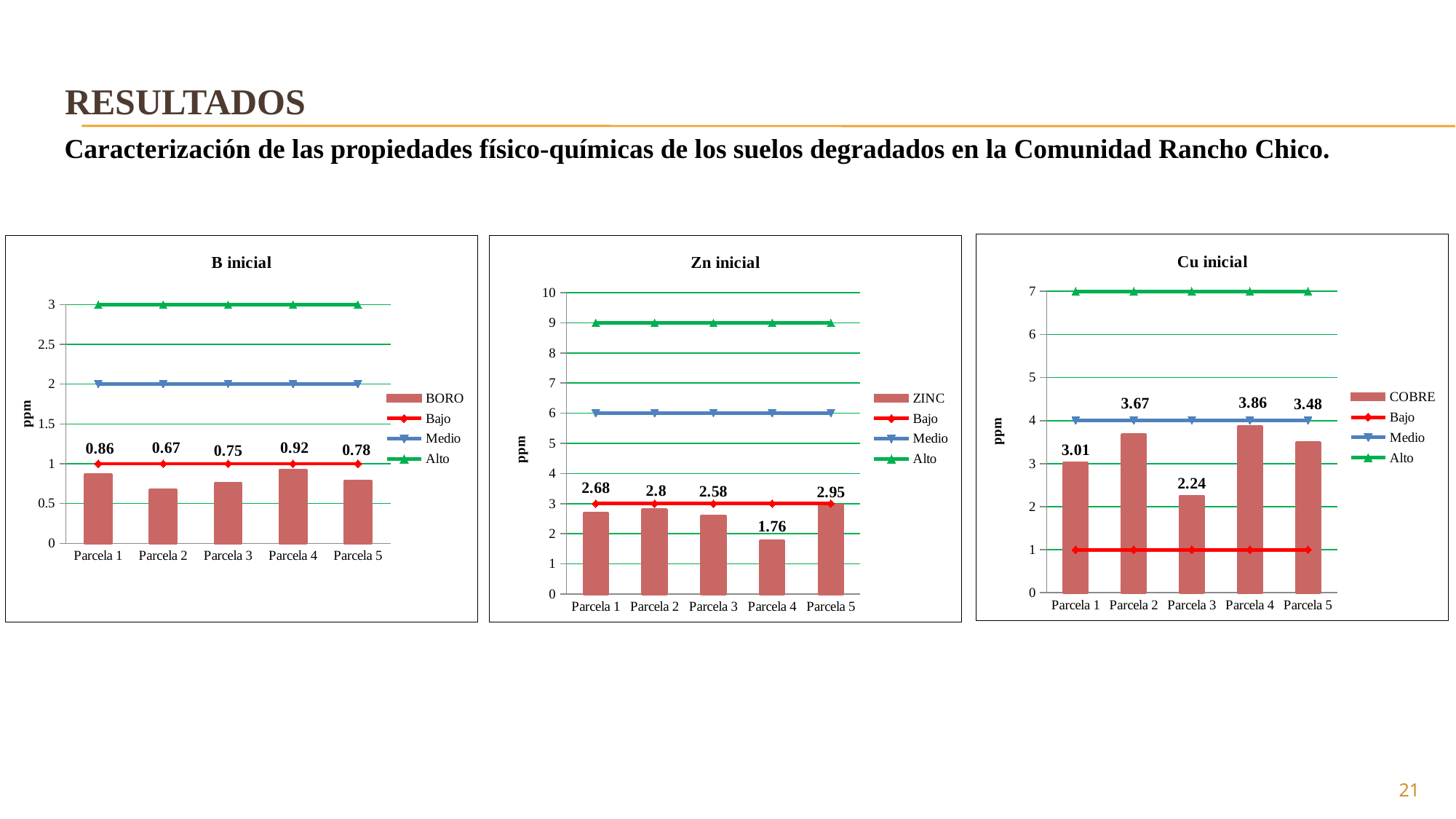
In the 'Cu inicial' chart, what is the COBRE value for Parcela 3? 2.24 What is the y-axis label of the 'B inicial' chart? ppm In the 'B inicial' chart, which parcela has the lowest BORO value? Parcela 2 In the 'Zn inicial' chart, which parcela has the highest ZINC value? Parcela 5 In the 'Cu inicial' chart, which parcela has the highest COBRE value? Parcela 4 How many parcelas are shown on the x axis of the 'Zn inicial' chart? 5 In the 'B inicial' chart, what is the difference between the BORO values for Parcela 4 and Parcela 2? 0.25 In the 'Cu inicial' chart, what is the difference between the COBRE values for Parcela 2 and Parcela 5? 0.19 In the 'B inicial' chart, what is the BORO value for Parcela 4? 0.92 How many series does the legend of the 'Cu inicial' chart list? 4 In the 'Zn inicial' chart, what is the ZINC value for Parcela 4? 1.76 In the 'Zn inicial' chart, is the ZINC value for Parcela 1 larger or smaller than the value for Parcela 2? smaller